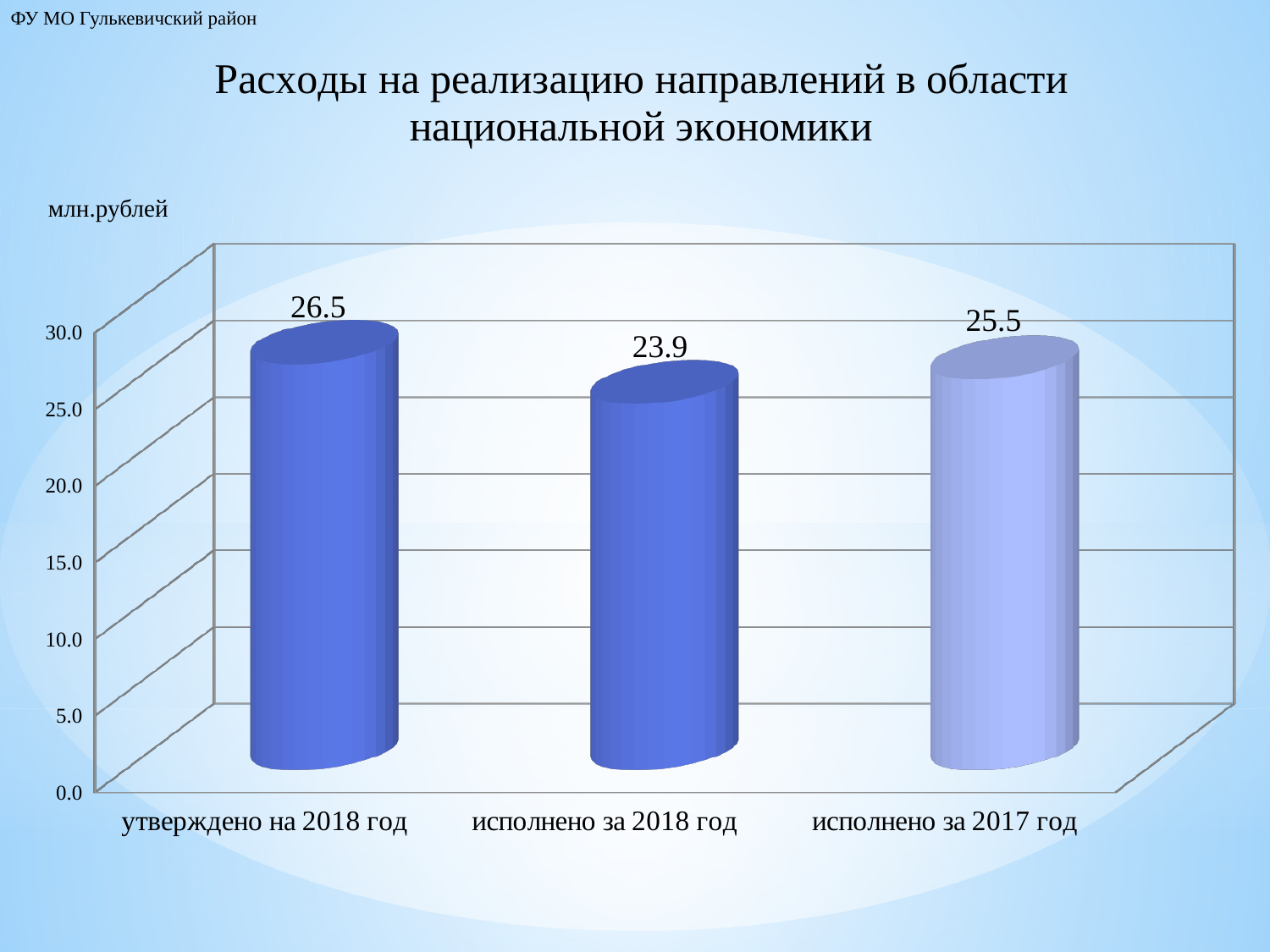
What unit of measurement is indicated above the chart? млн.рублей What is the difference between «исполнено за 2017 год» and «исполнено за 2018 год»? 1.6 How many categories are shown in the chart? 3 What is the value for «утверждено на 2018 год»? 26.5 Is the value for «исполнено за 2018 год» greater or less than 25.0? less What is the value for «исполнено за 2017 год»? 25.5 What is the value for «исполнено за 2018 год»? 23.9 Which is larger: «исполнено за 2018 год» or «исполнено за 2017 год»? исполнено за 2017 год What is the difference between «утверждено на 2018 год» and «исполнено за 2018 год»? 2.6 Which category has the lowest value? исполнено за 2018 год What kind of chart is shown on the slide? bar chart Which category has the highest value? утверждено на 2018 год